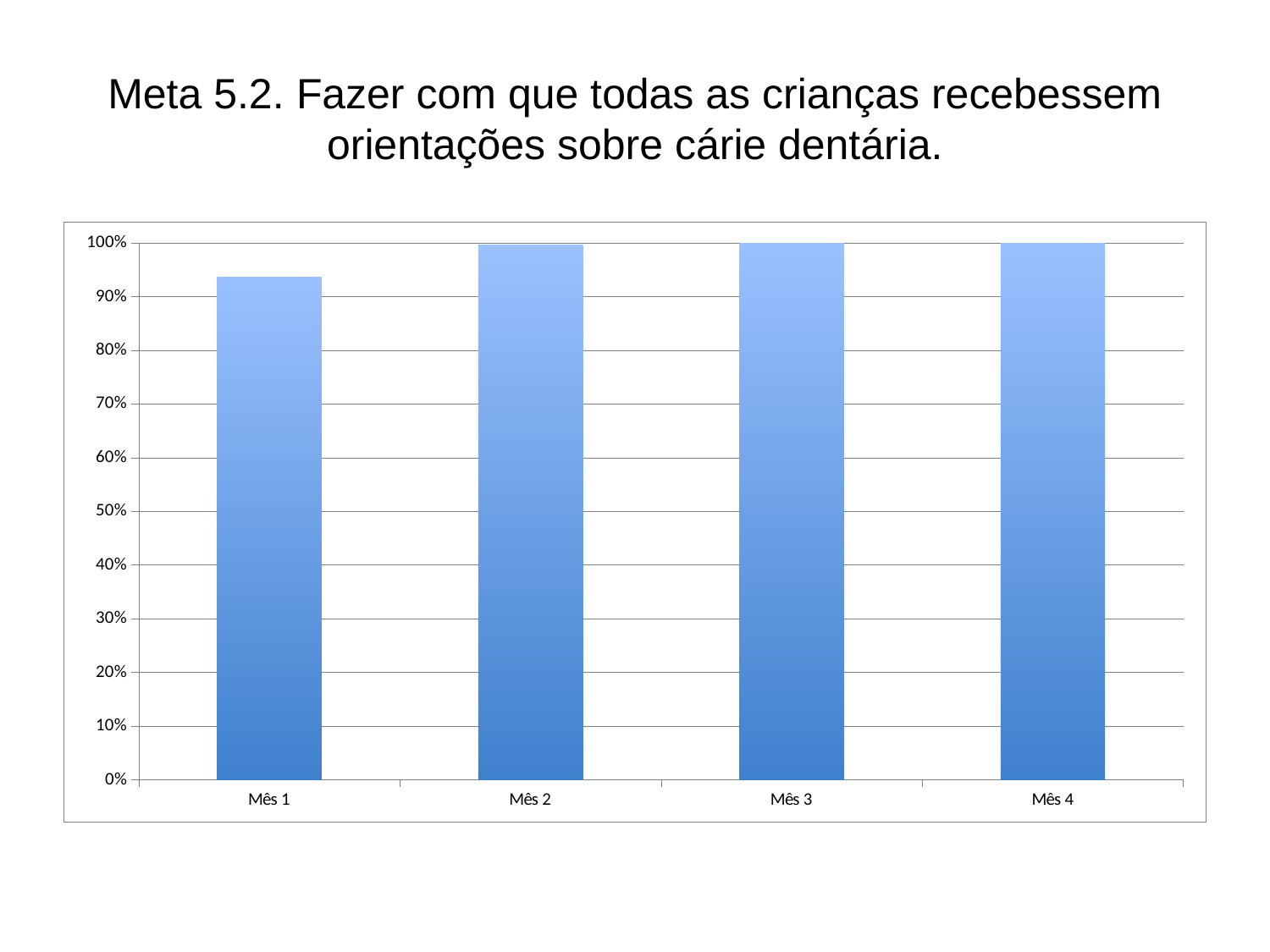
Which is larger, the value for Mês 1 or the value for Mês 4? Mês 4 Is the value for Mês 1 greater or less than 100%? less What is the value for Mês 4 in the chart? 100% Is the value for Mês 2 greater or less than 90%? greater Which is larger, the value for Mês 1 or the value for Mês 2? Mês 2 Is the value for Mês 1 greater or less than 90%? greater Do the values generally rise or fall from Mês 1 to Mês 4? rise How many categories (months) are shown on the x axis of the chart? 4 What is the title of the slide containing the chart? Meta 5.2. Fazer com que todas as crianças recebessem orientações sobre cárie dentária. Which month has the lowest value in the chart? Mês 1 What is the highest value shown on the y axis of the chart? 100% What kind of chart is shown on the slide? bar chart